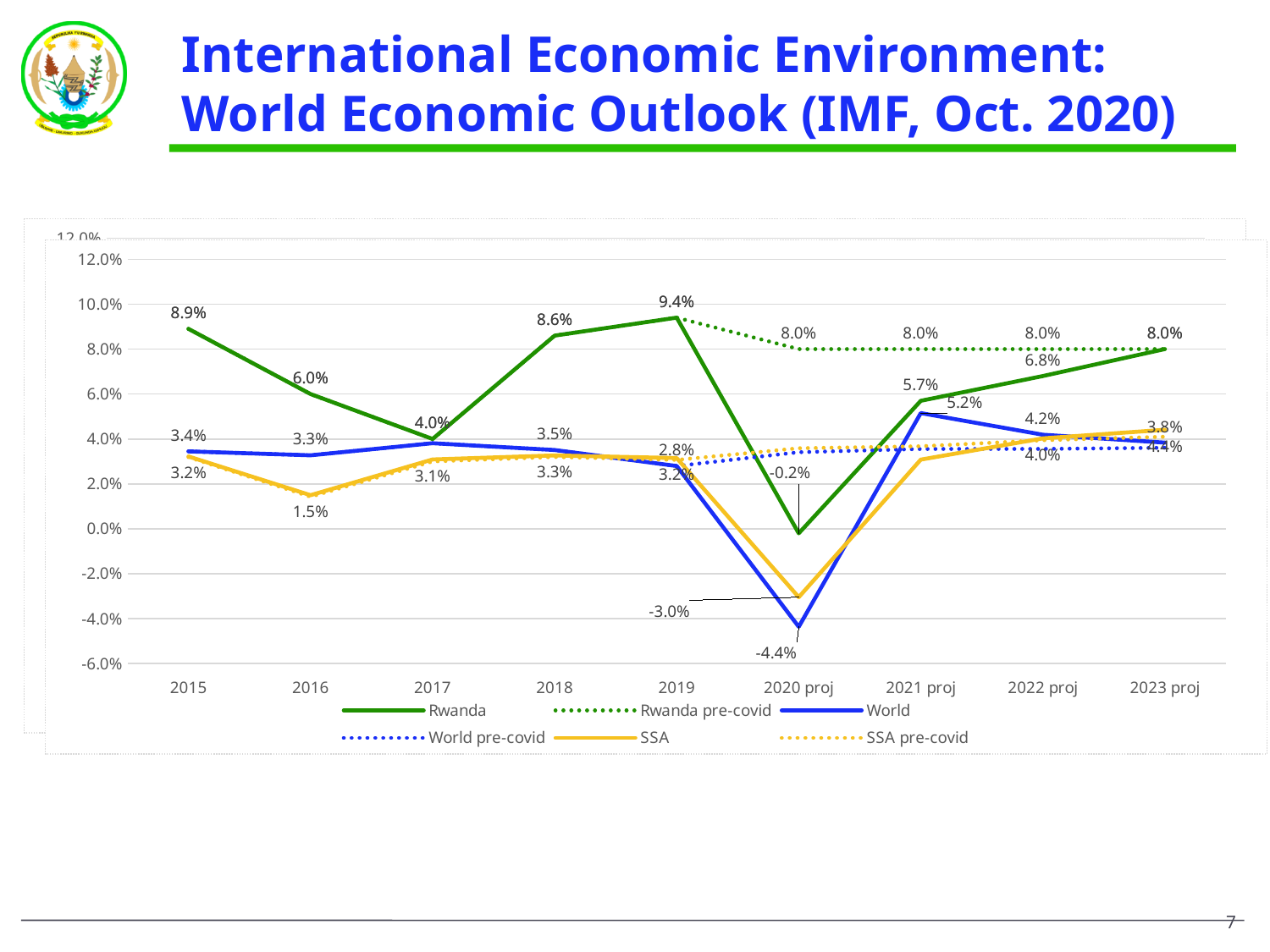
What is the value for World in 2020 proj? -4.4% What is the value for Rwanda in 2015? 8.9% What is the value for Rwanda in 2020 proj? -0.2% How many years are shown along the x axis? 9 Which is larger, the Rwanda value in 2015 or in 2018? 2015 Is the value for World in 2017 greater or less than 2.0%? greater What is the value for SSA in 2016? 1.5% How many series does the legend list? 6 In which year does the Rwanda series reach its highest value? 2019 In which year does the Rwanda series reach its lowest value? 2020 proj What kind of chart is shown on the slide? line chart What is the difference between the Rwanda value in 2019 and in 2020 proj? 9.6 percentage points